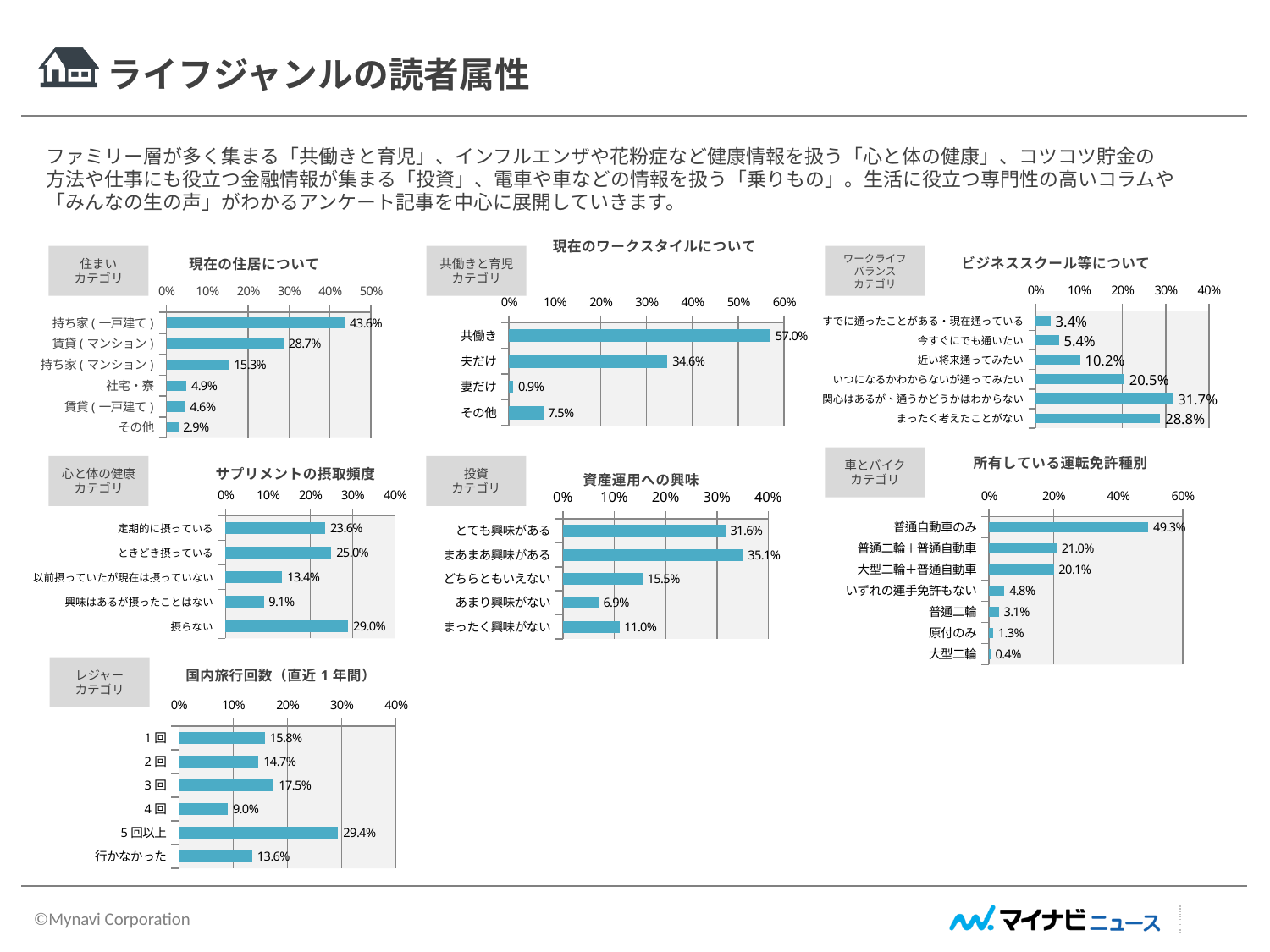
How many charts are shown on the slide? 7 In the ビジネススクール等について chart, what is the difference between 関心はあるが、通うかどうかはわからない and まったく考えたことがない? 2.9% What type of chart is the 現在の住居について chart? Bar chart In the 所有している運転免許種別 chart, what is the value for 大型二輪? 0.4% In the 所有している運転免許種別 chart, how many categories are shown? 7 In the 国内旅行回数（直近1年間） chart, what is the difference between 3回 and 4回? 8.5% In the 資産運用への興味 chart, which is larger: とても興味がある or まあまあ興味がある? まあまあ興味がある In the サプリメントの摂取頻度 chart, which category has the lowest value? 興味はあるが摂ったことはない In the 国内旅行回数（直近1年間） chart, what is the value for 5回以上? 29.4% In the 現在のワークスタイルについて chart, which category has the highest value? 共働き In the 現在の住居について chart, what is the value for 持ち家(一戸建て)? 43.6% In the 現在のワークスタイルについて chart, what is the value for 妻だけ? 0.9%